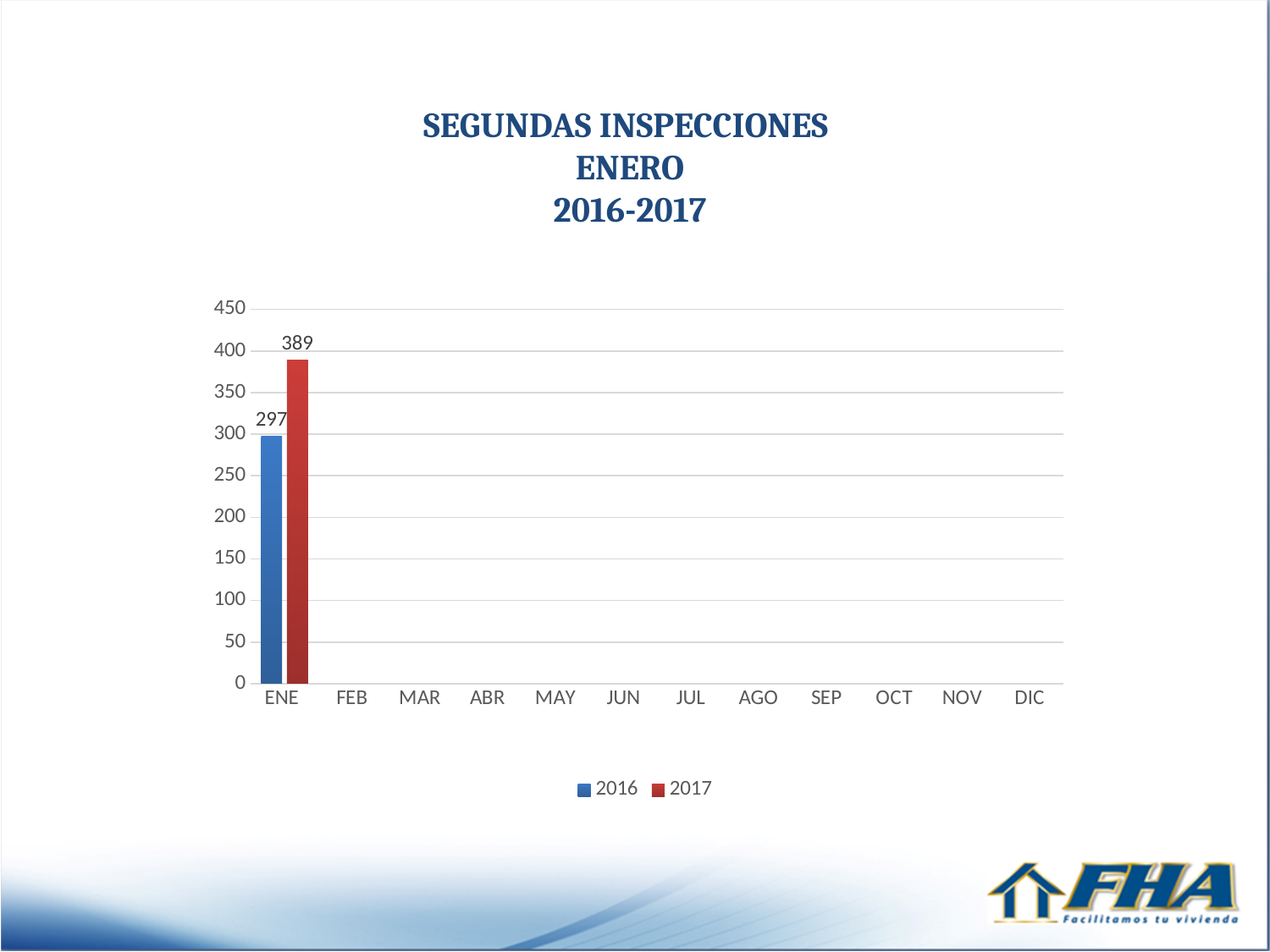
Which month is the only one with plotted bars? ENE How many series does the legend list? 2 What is the value for 2017 in ENE? 389 Which series has the higher value in ENE, 2016 or 2017? 2017 Is the value for 2016 in ENE greater or less than 300? less What is the value for 2016 in ENE? 297 What is the title of the chart? SEGUNDAS INSPECCIONES ENERO 2016-2017 How many month categories are shown on the x axis? 12 Is the value for 2017 in ENE greater or less than 350? greater What is the difference between the 2017 and 2016 values in ENE? 92 What kind of chart is shown on the slide? bar chart Which colour represents the 2017 series in the legend? red